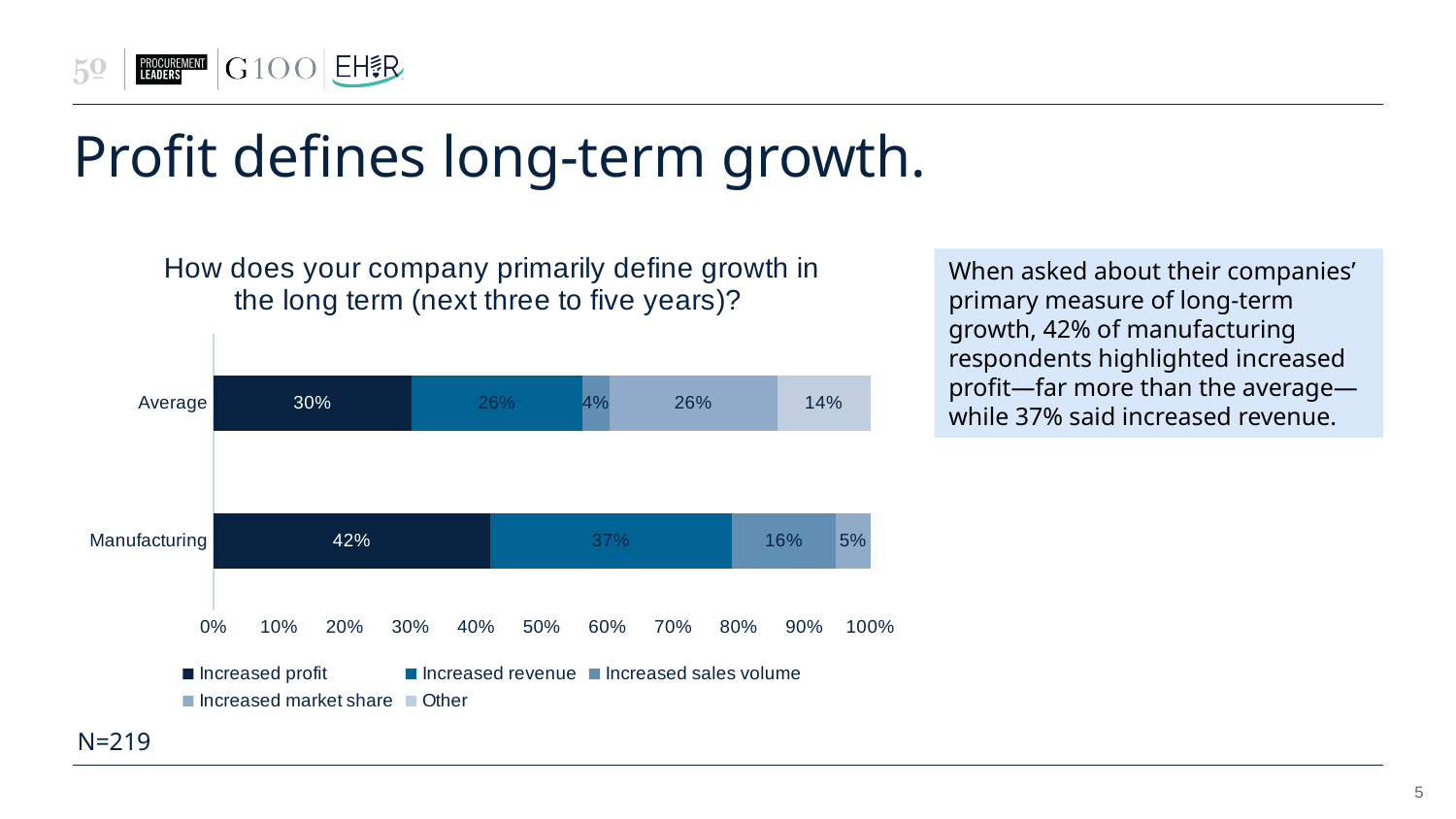
What is the Increased revenue value for the Average bar? 26% How many categories (bars) are shown in the chart? 2 What is the Other value for the Average bar? 14% What is the Increased sales volume value for the Average bar? 4% What kind of chart is shown on the slide? Stacked bar chart What percentage of Manufacturing respondents chose Increased revenue? 37% What is the Increased profit value for the Average bar? 30% Which bar has the larger Increased revenue share, Average or Manufacturing? Manufacturing What percentage of Manufacturing respondents chose Increased profit? 42% How many series does the legend list? 5 How many percentage points higher is Increased profit for Manufacturing than for Average? 12 percentage points